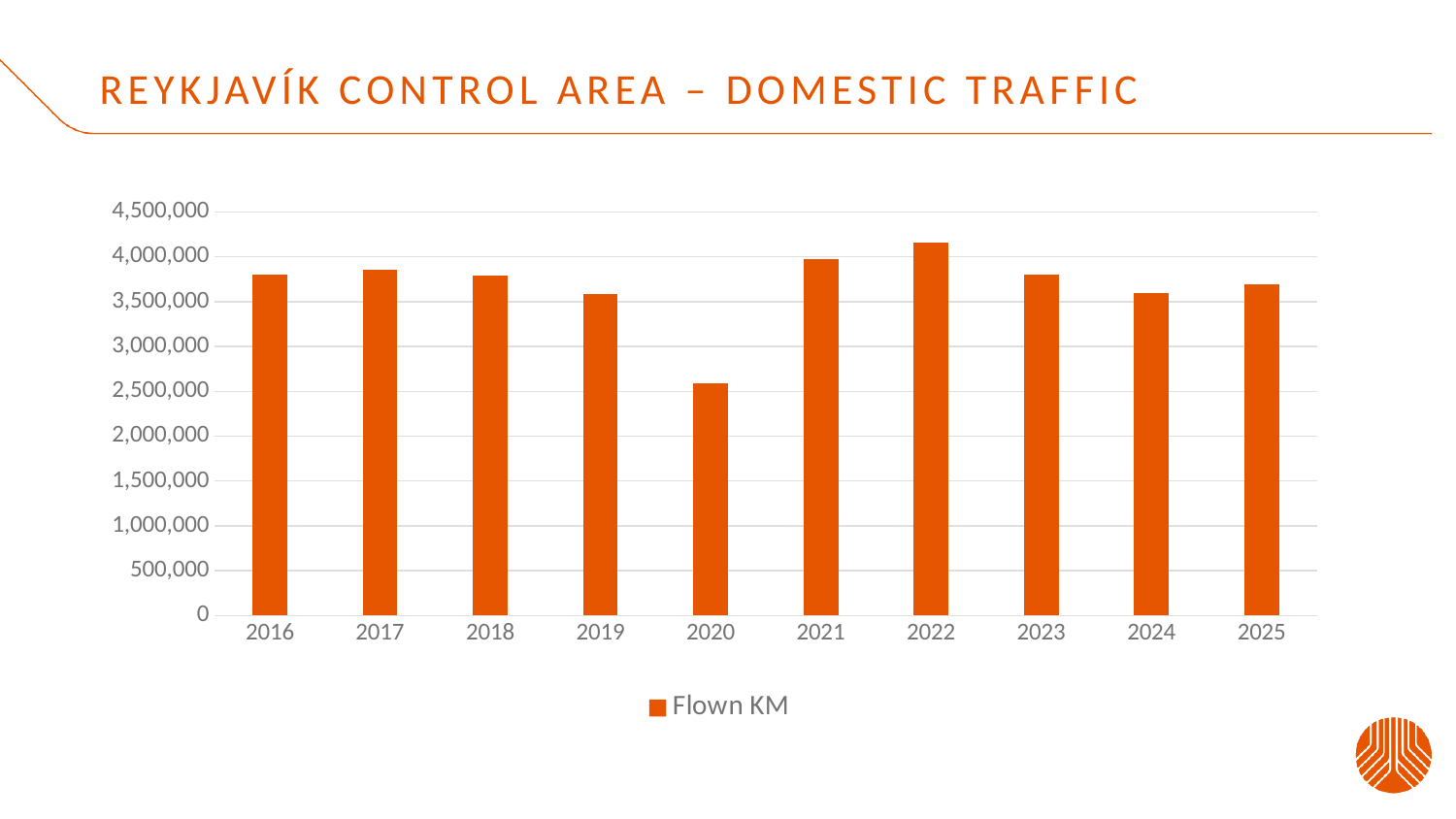
What is the name of the series shown in the legend? Flown KM How many series does the legend list? 1 Is the Flown KM value for 2020 greater or less than 3,000,000? less Is the Flown KM value for 2019 greater or less than 3,500,000? greater Do the Flown KM values rise or fall from 2020 to 2022? rise What kind of chart is shown on the slide? Bar chart Which year has the highest Flown KM value? 2022 Is the Flown KM value for 2016 greater or less than 4,000,000? less Which year has the lowest Flown KM value? 2020 Which year has the larger Flown KM value, 2020 or 2021? 2021 How many years are shown on the x axis of the chart? 10